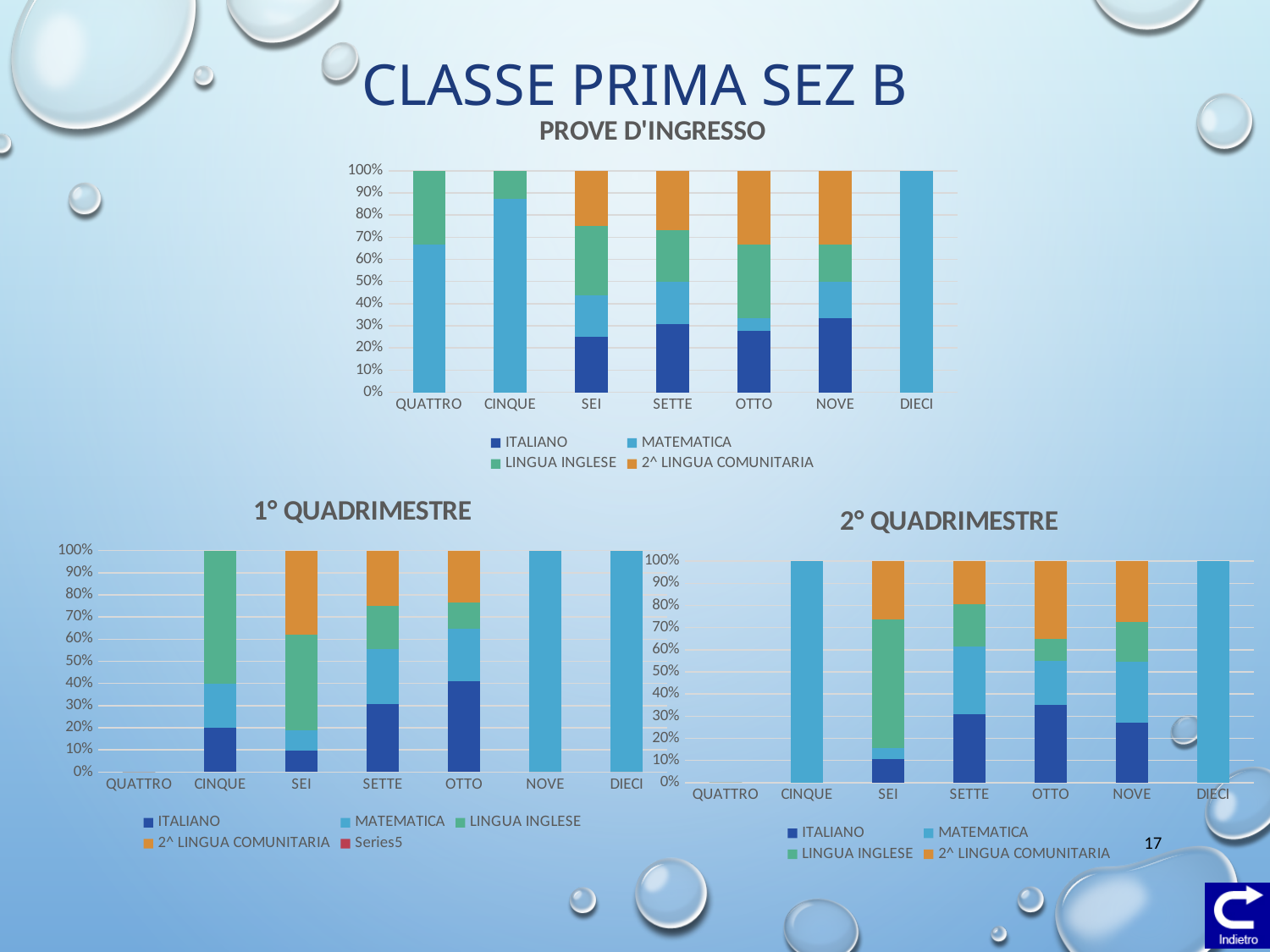
In the 2° QUADRIMESTRE chart, is the ITALIANO share for SEI greater or less than 20%? less In the 1° QUADRIMESTRE chart, is the ITALIANO share for OTTO greater or less than 30%? greater Which category in the 1° QUADRIMESTRE chart has no bar plotted? QUATTRO What type of chart is the PROVE D'INGRESSO chart? Stacked bar chart What is the title of the chart at the bottom right of the slide? 2° QUADRIMESTRE How many series does the legend of the PROVE D'INGRESSO chart list? 4 How many categories are shown on the x axis of the PROVE D'INGRESSO chart? 7 In the PROVE D'INGRESSO chart, is the MATEMATICA share for CINQUE greater or less than 80%? greater In the 2° QUADRIMESTRE chart, which has the larger ITALIANO share, SEI or OTTO? OTTO In the 2° QUADRIMESTRE chart, what percentage does MATEMATICA account for in the CINQUE bar? 100% In the PROVE D'INGRESSO chart, what percentage does MATEMATICA account for in the DIECI bar? 100% How many series does the legend of the 1° QUADRIMESTRE chart list? 5